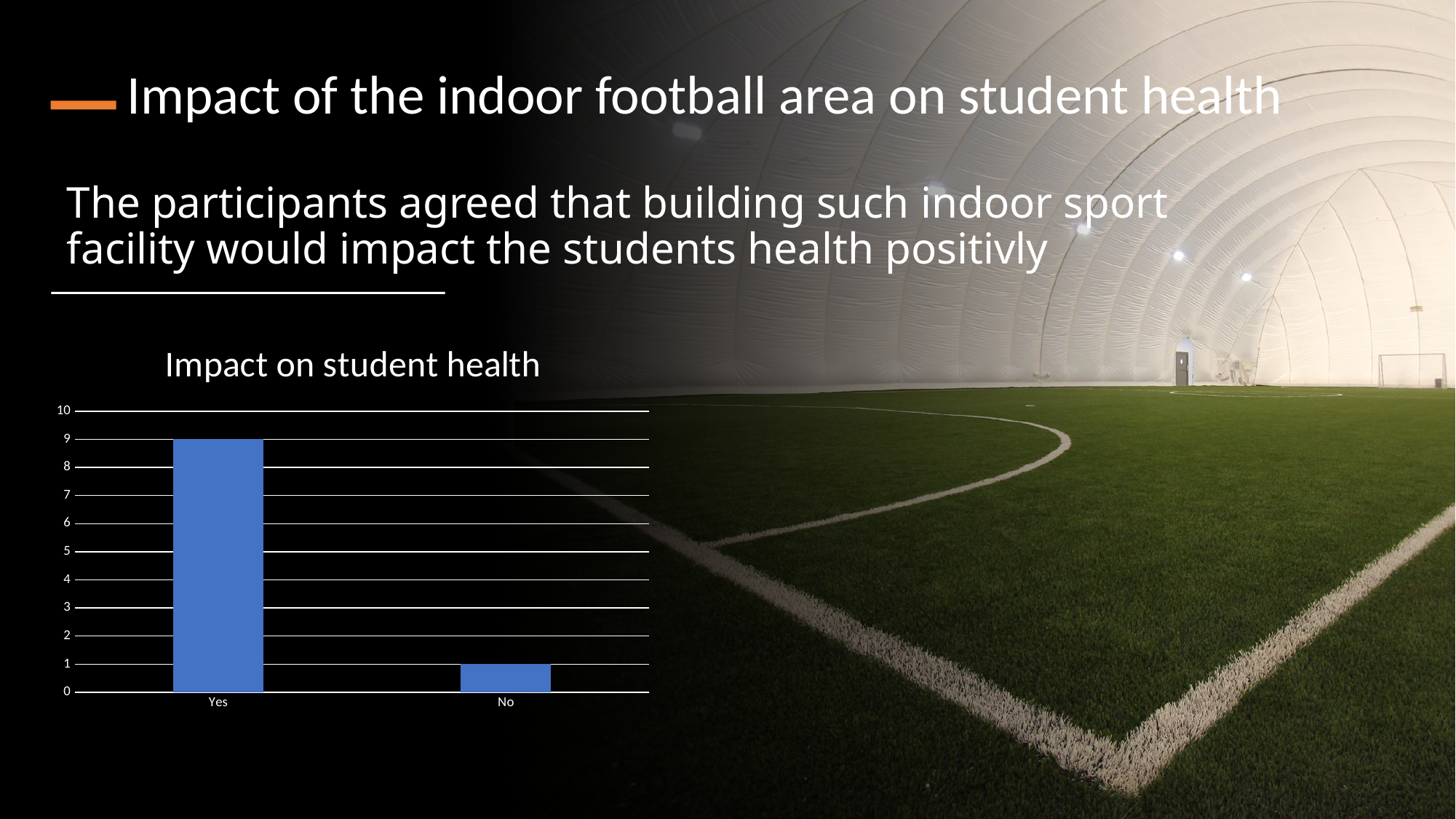
What kind of chart is the Impact on student health chart? bar chart What is the title of the chart on the slide? Impact on student health What is the difference between the values for Yes and No in the Impact on student health chart? 8 What is the value for Yes in the Impact on student health chart? 9 How many categories are shown in the Impact on student health chart? 2 What is the value for No in the Impact on student health chart? 1 Which category has the lowest value in the Impact on student health chart? No What is the highest value shown on the vertical axis of the Impact on student health chart? 10 Is the value for Yes in the Impact on student health chart greater or less than 5? greater Is the value for No in the Impact on student health chart greater or less than 5? less Which is larger in the Impact on student health chart, the value for Yes or the value for No? Yes Which category has the highest value in the Impact on student health chart? Yes